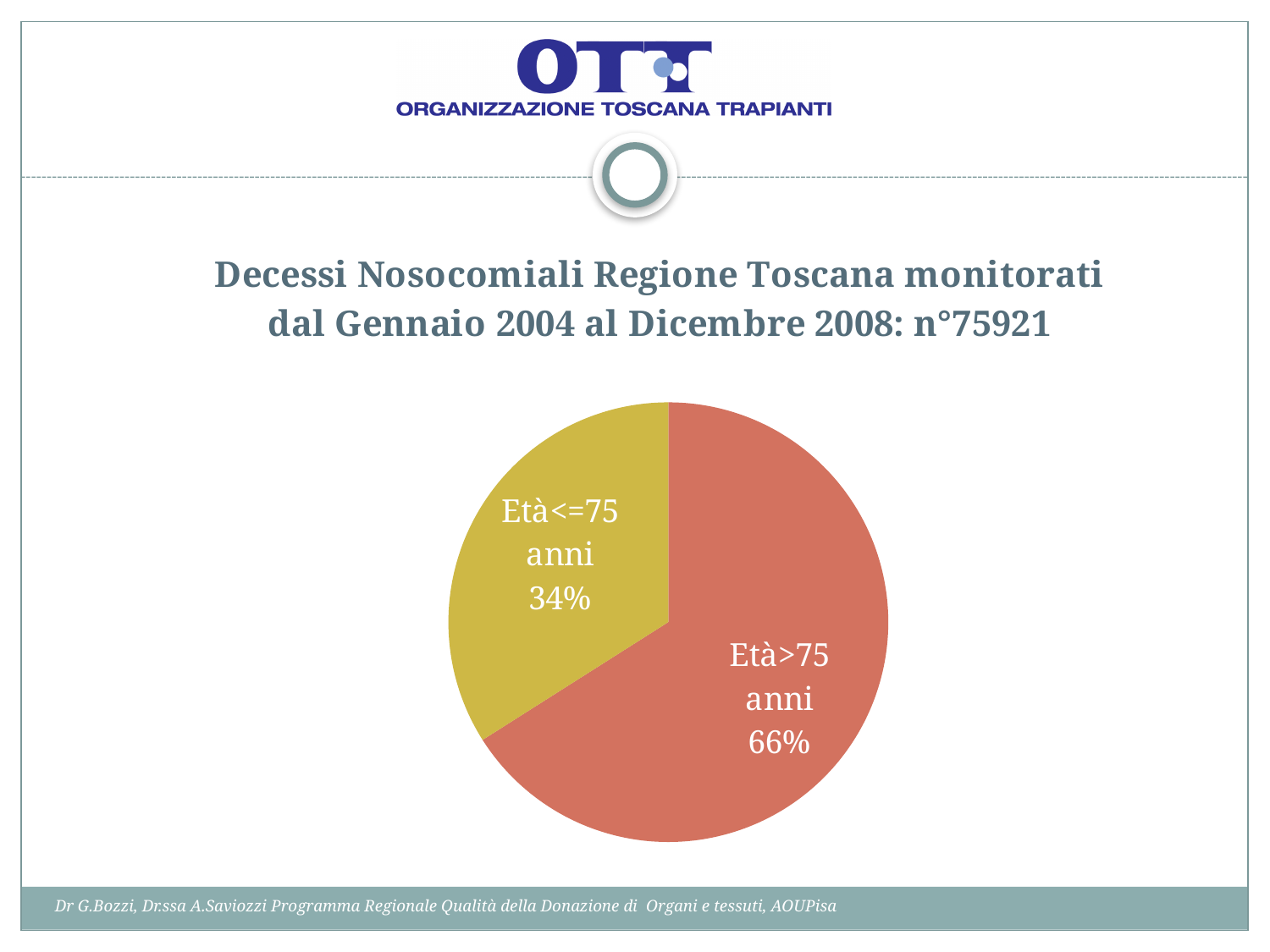
What kind of chart is shown on the slide? pie chart Which slice of the pie is the smallest? Età<=75 anni What share of the pie is labelled "Età>75 anni"? 66% What share of the pie is labelled "Età<=75 anni"? 34% What colour is the "Età>75 anni" slice? red What is the total number of deaths stated in the chart title? 75921 How many slices does the pie chart have? 2 Which slice of the pie is the largest? Età>75 anni What is the difference in percentage points between the "Età>75 anni" slice and the "Età<=75 anni" slice? 32 Which is larger, the share for "Età>75 anni" or the share for "Età<=75 anni"? Età>75 anni